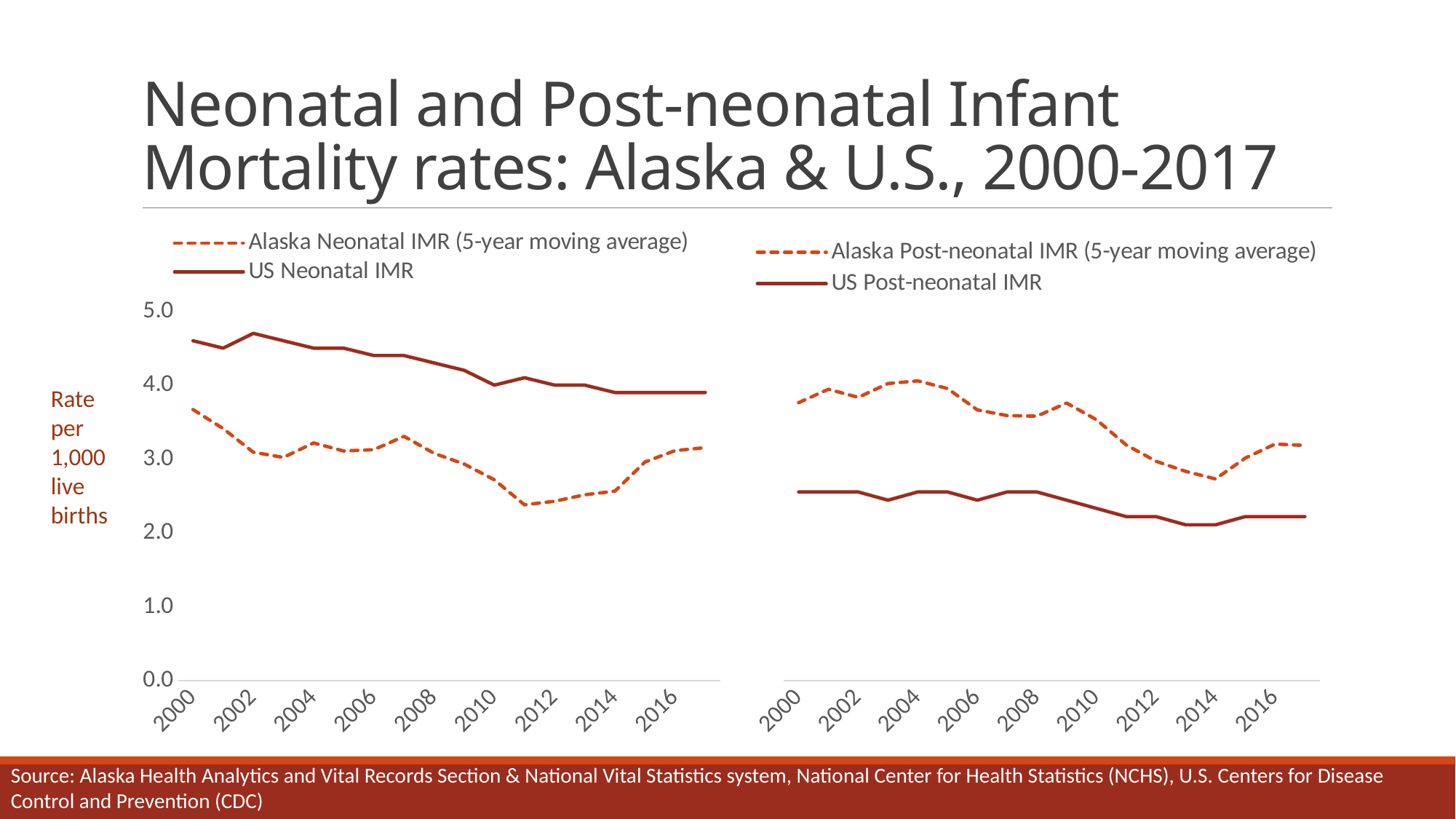
In the left (neonatal) chart, is the US Neonatal IMR value for 2000 greater or less than 4.0? greater In the right (post-neonatal) chart, is the US Post-neonatal IMR value for 2000 greater or less than 3.0? less How many series does the legend of the right (post-neonatal) chart list? 2 What is the label on the vertical axis of the charts? Rate per 1,000 live births In the right (post-neonatal) chart, is the Alaska Post-neonatal IMR value for 2014 greater or less than 3.0? less What kind of chart is the left chart on the slide? Line chart In the left (neonatal) chart, does the US Neonatal IMR line generally rise or fall from 2000 to 2017? Fall In the left (neonatal) chart, which series has the higher value in 2000, US Neonatal IMR or Alaska Neonatal IMR? US Neonatal IMR In the right (post-neonatal) chart, which series has the higher value in 2010, Alaska Post-neonatal IMR or US Post-neonatal IMR? Alaska Post-neonatal IMR How many series does the legend of the left (neonatal) chart list? 2 How many year labels are shown on the x axis of the right (post-neonatal) chart? 9